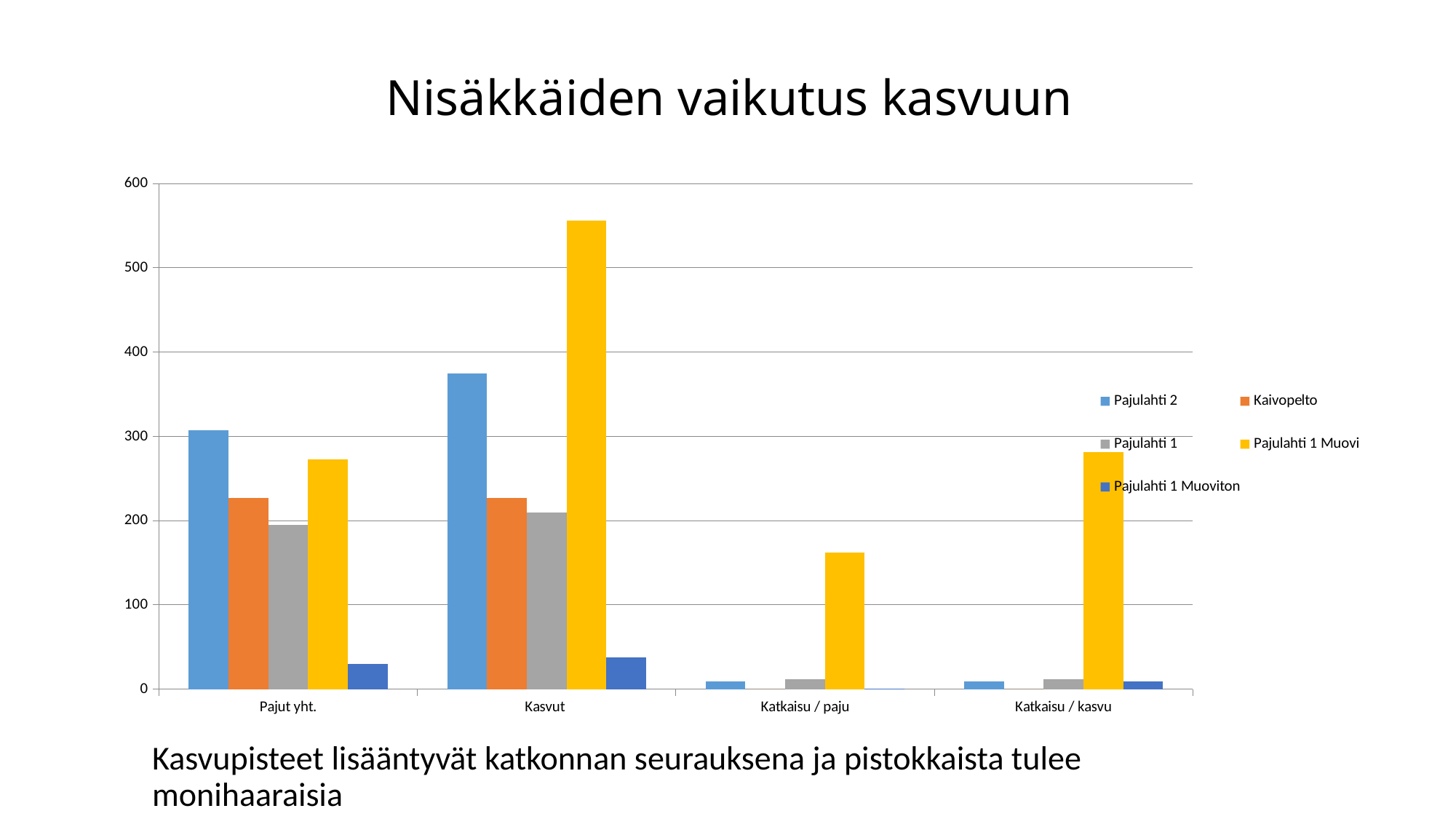
How many series does the legend list? 5 Is the value for Pajulahti 1 Muovi in the Katkaisu / paju category greater or less than 200? less How many categories are shown on the x axis of the chart? 4 Which series has the highest value in the Pajut yht. category? Pajulahti 2 Which category contains the tallest bar in the chart? Kasvut Which series has the highest value in the Kasvut category? Pajulahti 1 Muovi What is the title of the chart? Nisäkkäiden vaikutus kasvuun Which series has the lowest value in the Kasvut category? Pajulahti 1 Muoviton Is the value for Pajulahti 1 Muovi in the Kasvut category greater or less than 500? greater In the Kasvut category, which is larger: Pajulahti 2 or Kaivopelto? Pajulahti 2 Is the value for Pajulahti 2 in the Pajut yht. category greater or less than 200? greater What kind of chart is shown on the slide? bar chart